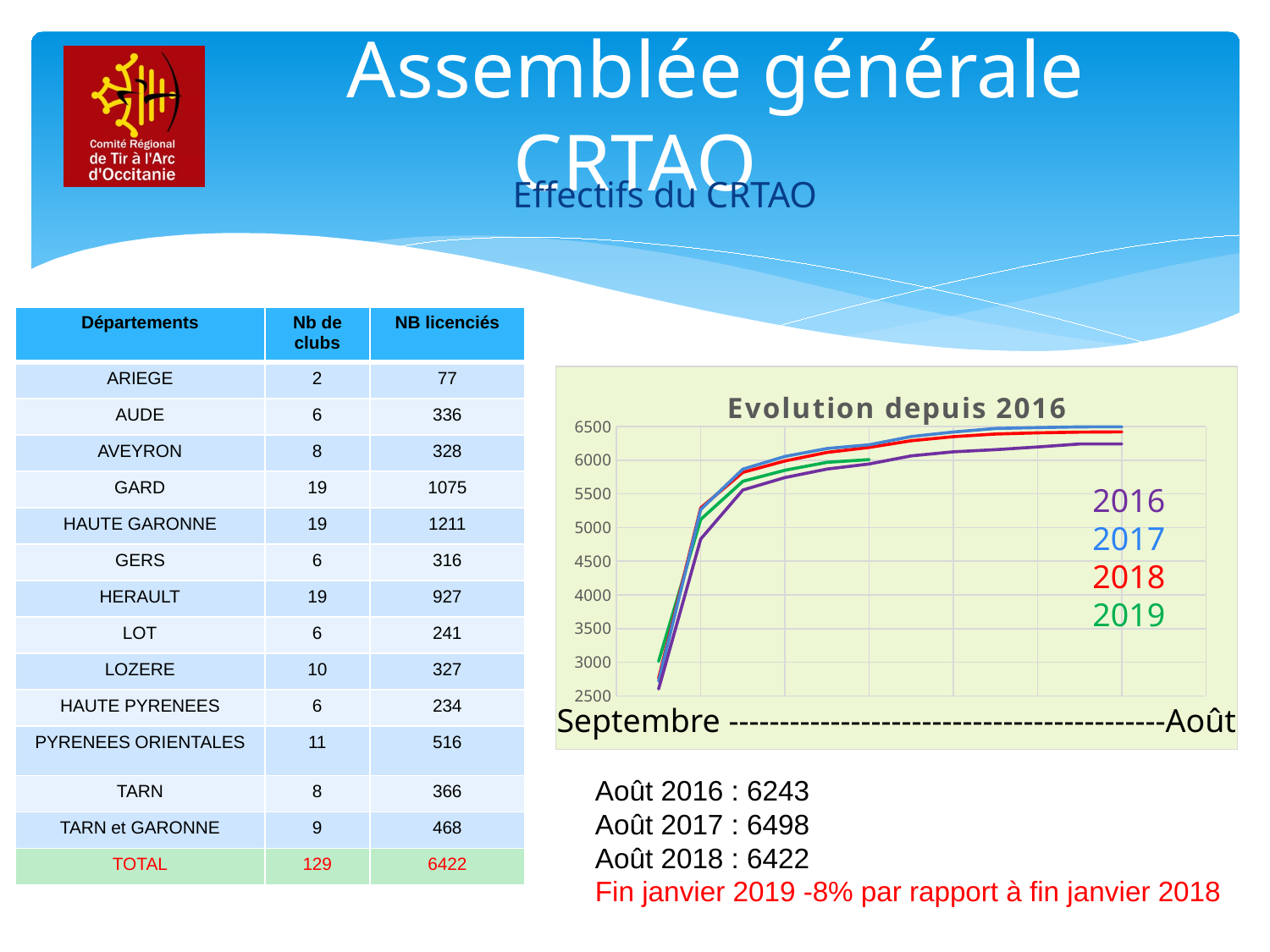
How many series (years) does the chart's legend list? 4 Is the starting value of the 2016 (purple) line in Septembre greater or less than 3000? less According to the slide, what was the value for Août 2016? 6243 What is the difference between the Août 2017 value and the Août 2018 value given on the slide? 76 What is the title of the chart? Evolution depuis 2016 According to the slide, what was the value for Août 2017? 6498 Which year's line ends highest at Août in the chart? 2017 What kind of chart is shown on the slide? line chart Do the values in the chart rise or fall from Septembre to Août? rise Which year's line ends lowest at Août among the full-year series (2016, 2017, 2018)? 2016 Which colour is used for the 2018 series in the chart? red Is the final value of the 2019 (green) line greater or less than 6500? less